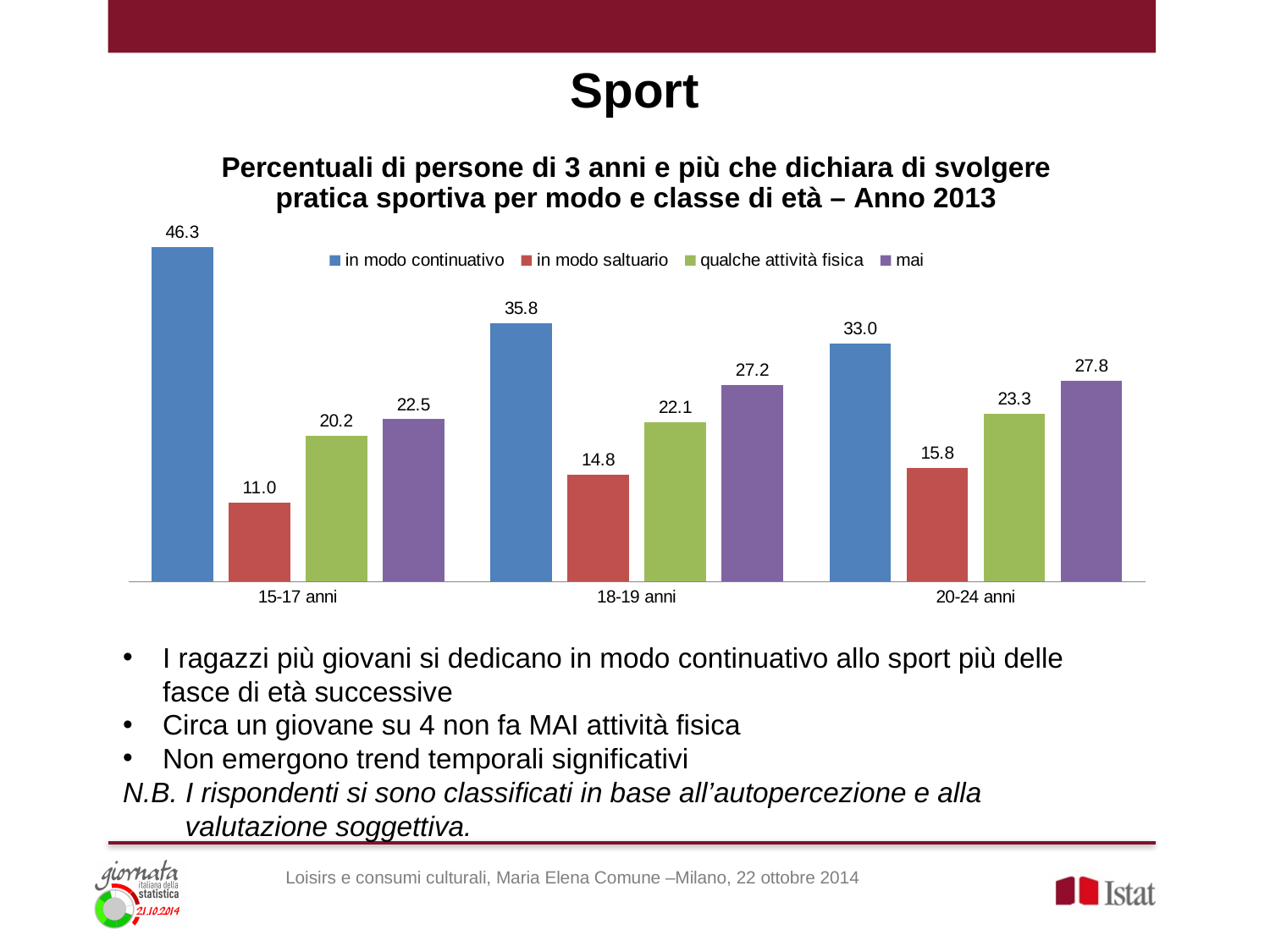
What is the value for "qualche attività fisica" in the 18-19 anni age group? 22.1 How many age groups are shown on the x axis? 3 What is the value for "in modo saltuario" in the 20-24 anni age group? 15.8 Which age group has the lowest value for "in modo saltuario"? 15-17 anni Which age group has the highest value for "in modo continuativo"? 15-17 anni How many series does the legend list? 4 What is the value for "mai" in the 18-19 anni age group? 27.2 Which is larger in the 20-24 anni group: "qualche attività fisica" or "mai"? mai Do the "in modo continuativo" values rise or fall across the age groups from 15-17 anni to 20-24 anni? Fall What is the value for "in modo continuativo" in the 15-17 anni age group? 46.3 What is the difference between the "in modo continuativo" values for 15-17 anni and 20-24 anni? 13.3 What kind of chart is shown on the slide? Bar chart